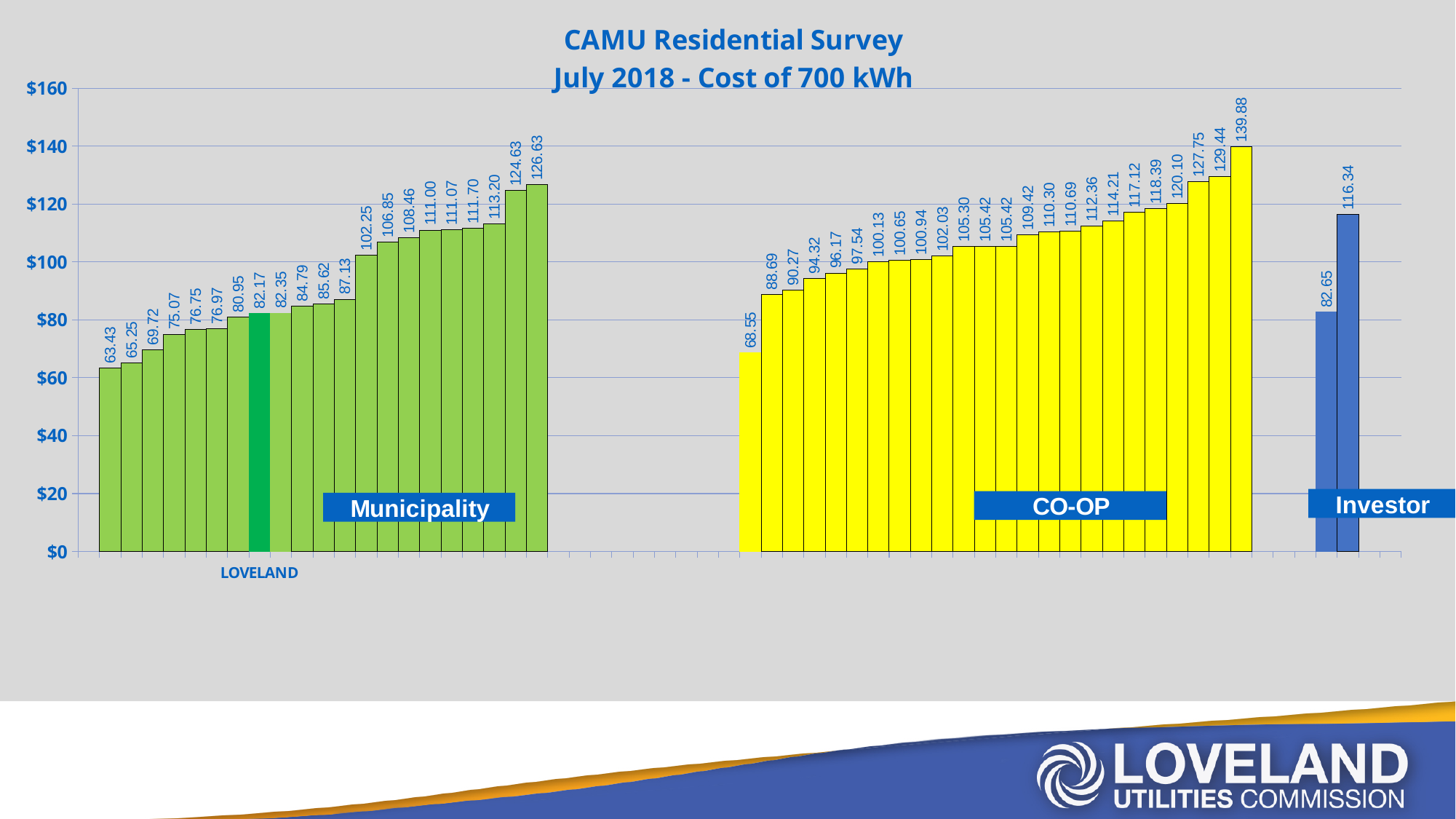
What is the highest value among the Municipality bars? 126.63 What is the highest value among the CO-OP bars? 139.88 What is the title of the chart? CAMU Residential Survey July 2018 - Cost of 700 kWh How many Investor bars are shown? 2 What kind of chart is shown on the slide? Bar chart What is the value of the Loveland bar? 82.17 What are the values of the two Investor bars? 82.65 and 116.34 What is the lowest value among the Municipality bars? 63.43 What is the difference between the two Investor bars? 33.69 What is the difference between the highest CO-OP bar and the highest Municipality bar? 13.25 What is the lowest value among the CO-OP bars? 68.55 Which group contains the tallest bar on the chart: Municipality, CO-OP or Investor? CO-OP